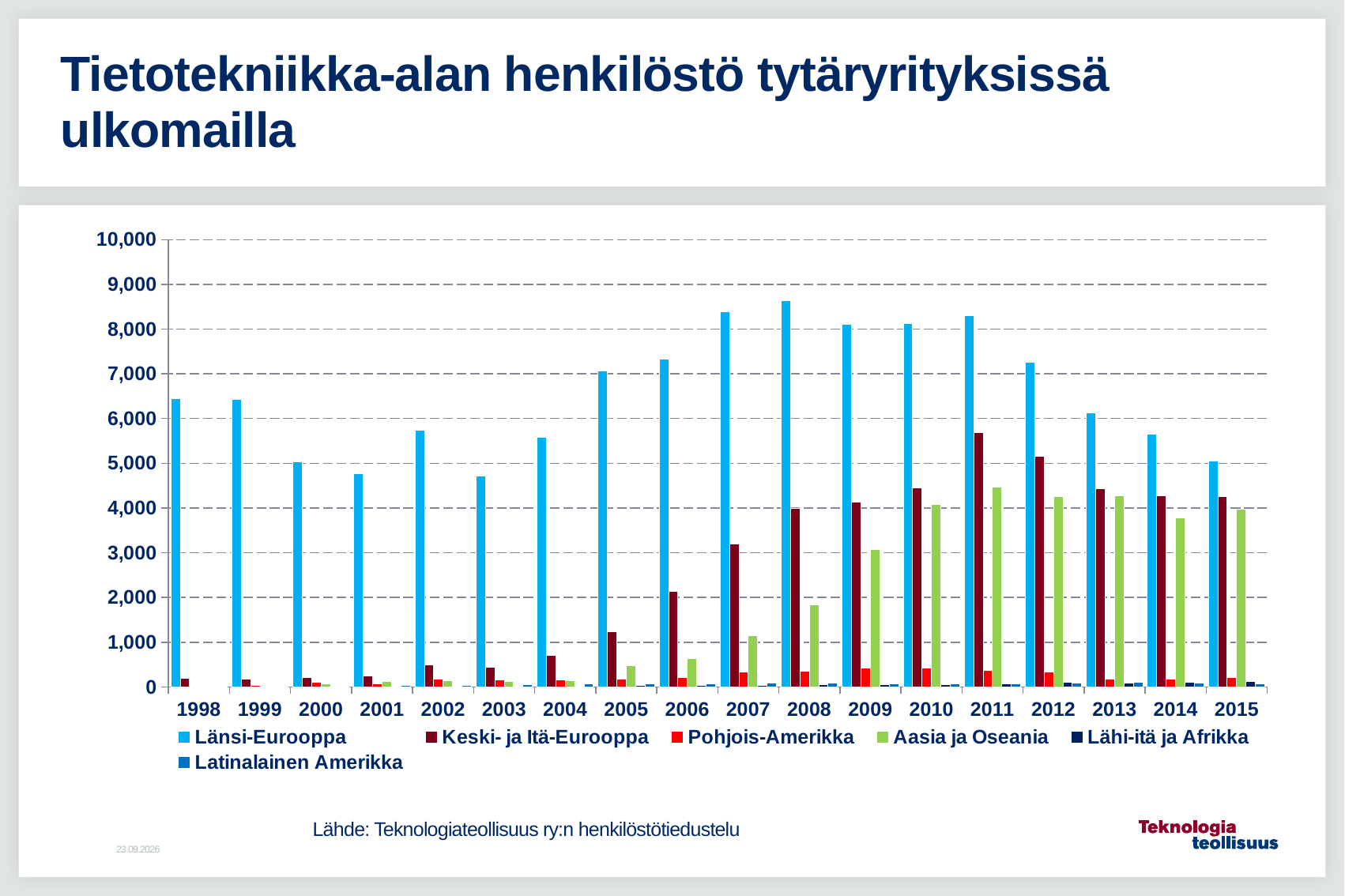
In which year is the value for Länsi-Eurooppa highest? 2008 Is the value for Keski- ja Itä-Eurooppa in 2011 greater or less than 5,000? greater How many series does the legend list? 6 How many years are shown on the x axis? 18 In 2011, which is larger: Keski- ja Itä-Eurooppa or Aasia ja Oseania? Keski- ja Itä-Eurooppa What is the title of the chart on the slide? Tietotekniikka-alan henkilöstö tytäryrityksissä ulkomailla Does the value for Länsi-Eurooppa rise or fall from 2011 to 2015? fall Is the value for Länsi-Eurooppa in 2012 greater or less than 7,000? greater In which year is the value for Keski- ja Itä-Eurooppa highest? 2011 Is the value for Länsi-Eurooppa in 2008 greater or less than 8,000? greater What kind of chart is shown on the slide? bar chart